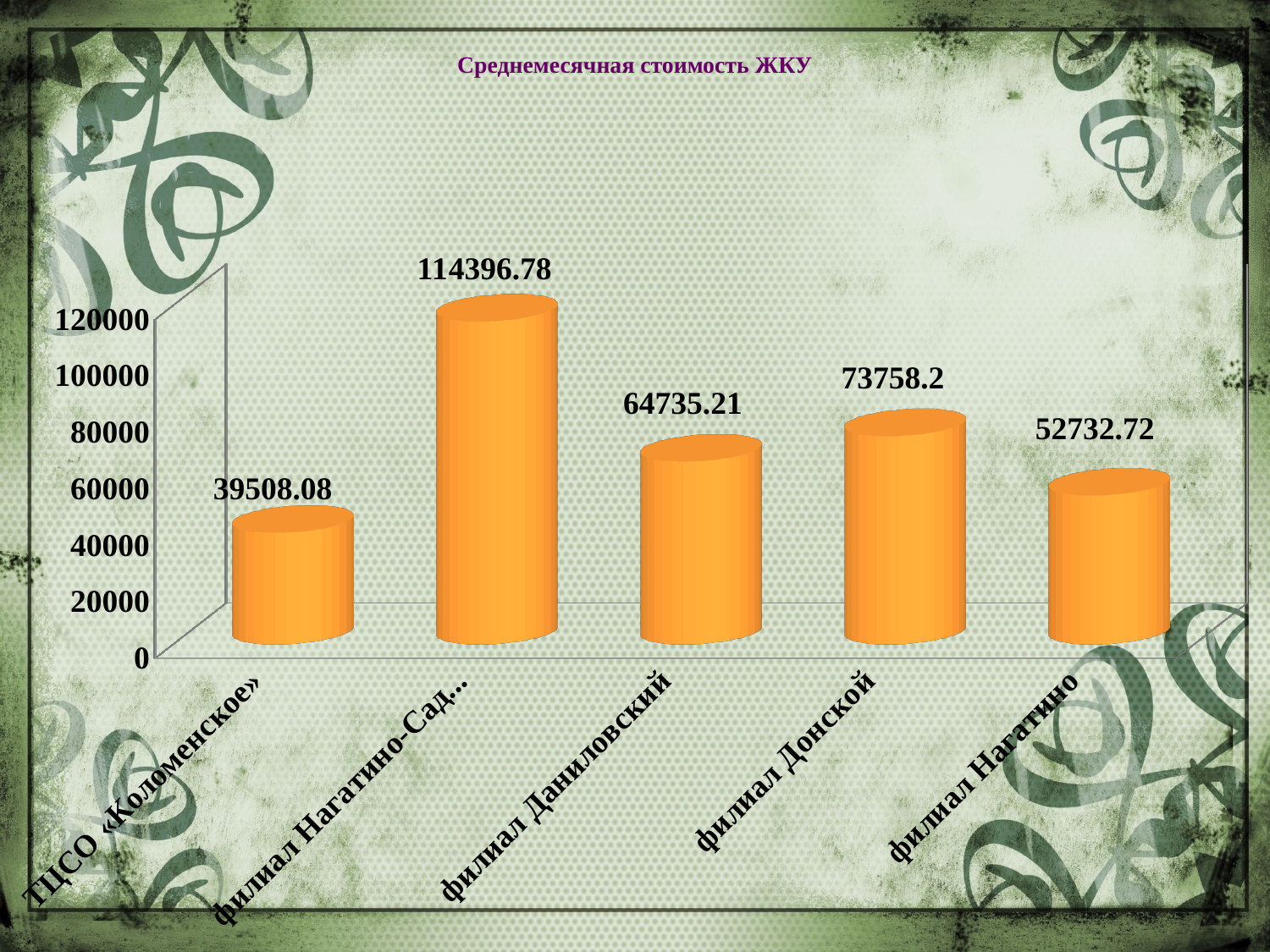
Which category has the highest value? филиал Нагатино-Сад... What kind of chart is shown on the slide? bar chart What is the difference between the values for филиал Донской and филиал Даниловский? 9022.99 What is the difference between the values for филиал Нагатино and ТЦСО «Коломенское»? 13224.64 Which is larger, the value for филиал Даниловский or the value for филиал Нагатино? филиал Даниловский Which category has the lowest value? ТЦСО «Коломенское» What is the value for филиал Донской? 73758.2 What is the value for ТЦСО «Коломенское»? 39508.08 What is the value for филиал Нагатино? 52732.72 How many categories are shown in the chart? 5 What is the value for филиал Даниловский? 64735.21 What is the title of the chart? Среднемесячная стоимость ЖКУ